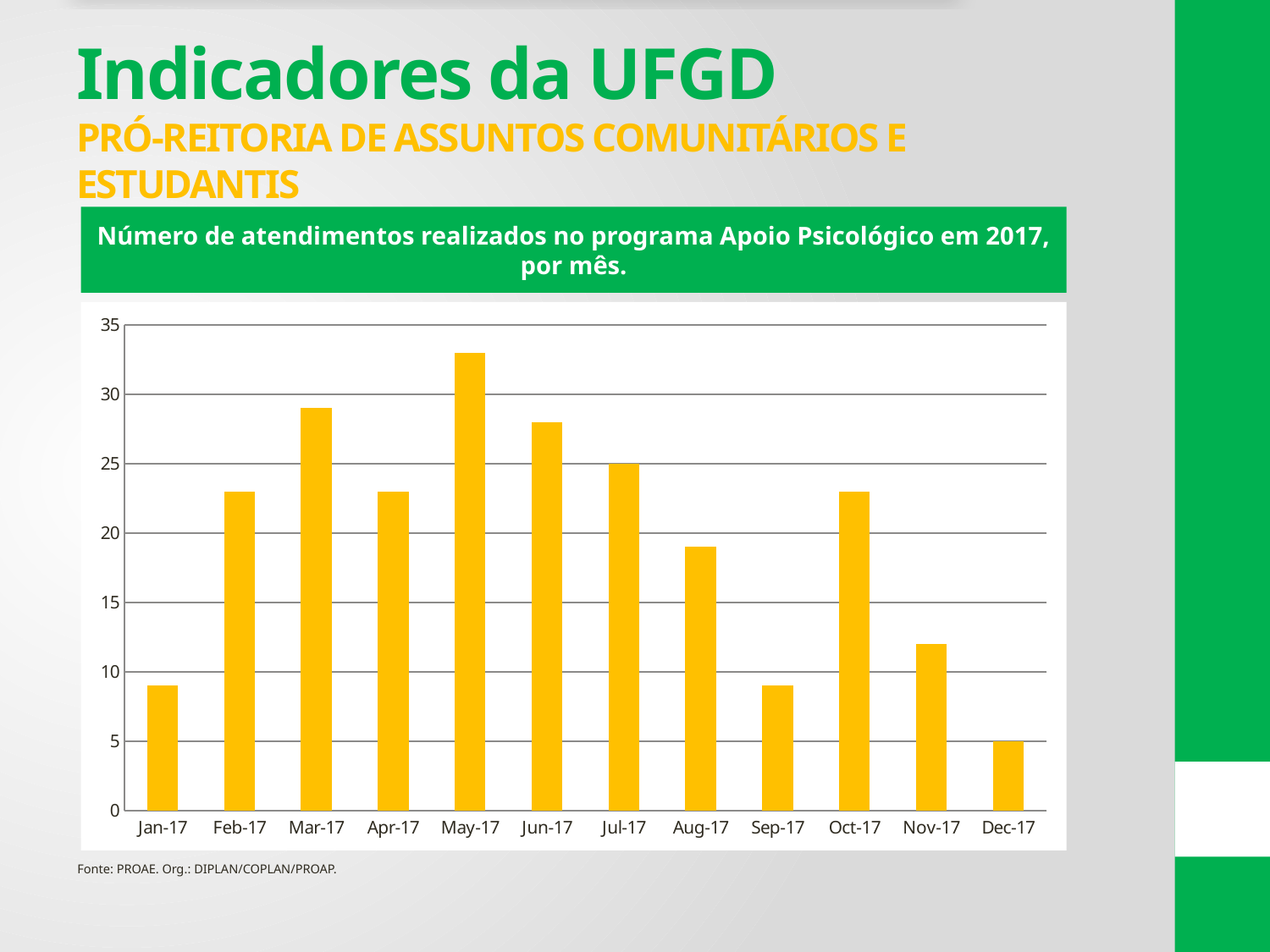
Which month has the highest number of atendimentos in the chart? May-17 Is the value for Mar-17 greater or less than 25? greater Which is larger, the value for May-17 or the value for Mar-17? May-17 Which month has the lowest number of atendimentos in the chart? Dec-17 What is the title of the chart? Número de atendimentos realizados no programa Apoio Psicológico em 2017, por mês. Is the value for Nov-17 greater or less than 10? greater What is the value for Jul-17 in the chart? 25 Is the value for Aug-17 greater or less than 20? less What is the value for Dec-17 in the chart? 5 What kind of chart is shown on the slide? bar chart Do the values rise or fall from May-17 to Sep-17? fall How many months are plotted on the x axis of the chart? 12